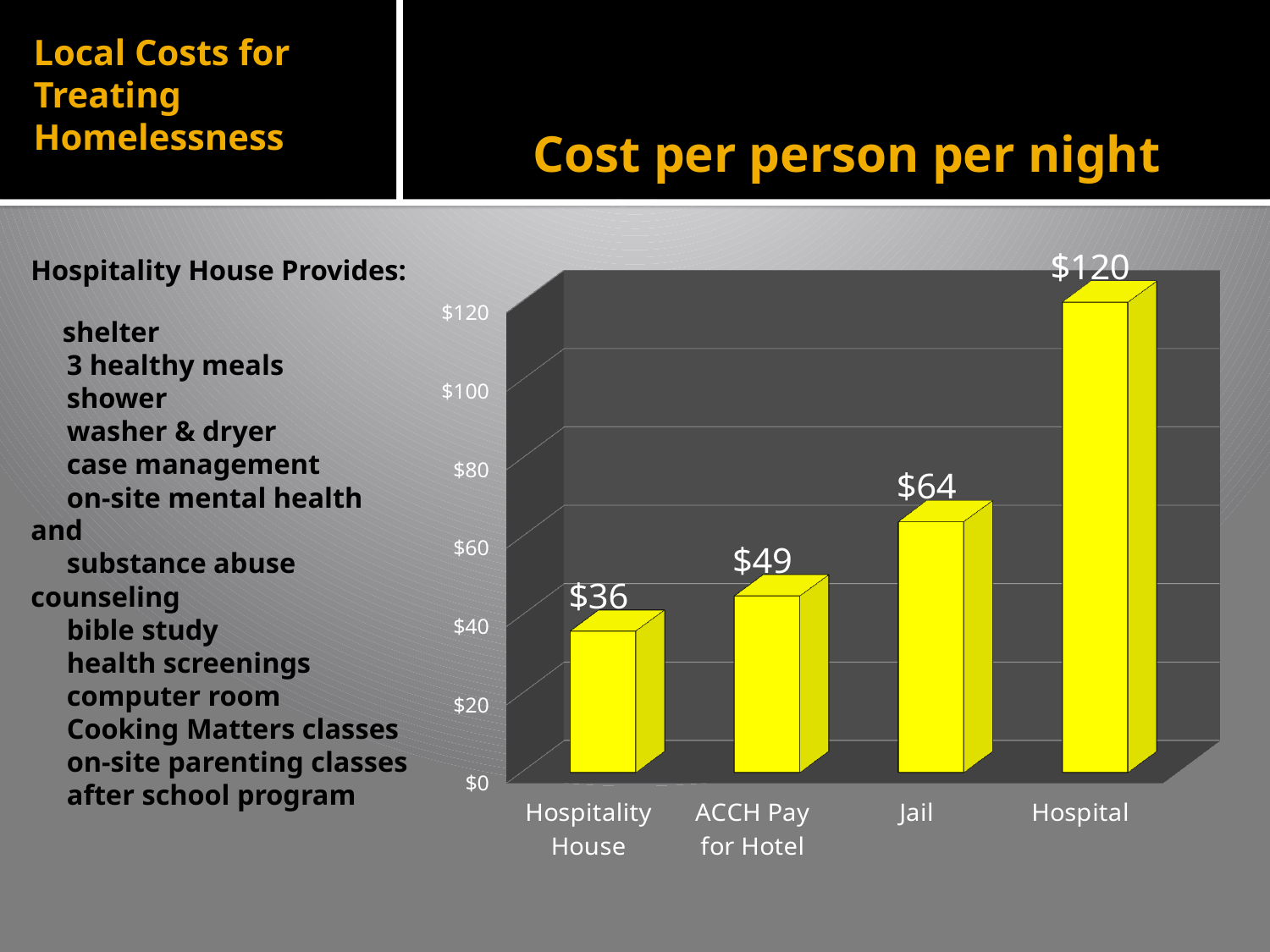
What is the difference in cost per person per night between Hospital and Hospitality House? $84 How many categories are shown in the chart? 4 What is the cost per person per night for Jail? $64 Do the values rise or fall from left to right across the categories? rise What is the cost per person per night for ACCH Pay for Hotel? $49 What is the difference in cost per person per night between Jail and ACCH Pay for Hotel? $15 What is the cost per person per night for Hospitality House? $36 What kind of chart is shown on the slide? bar chart Which category has the highest cost per person per night? Hospital Is the cost per person per night for Hospital greater or less than $100? greater Which category has the lowest cost per person per night? Hospitality House Which has a higher cost per person per night, Jail or ACCH Pay for Hotel? Jail